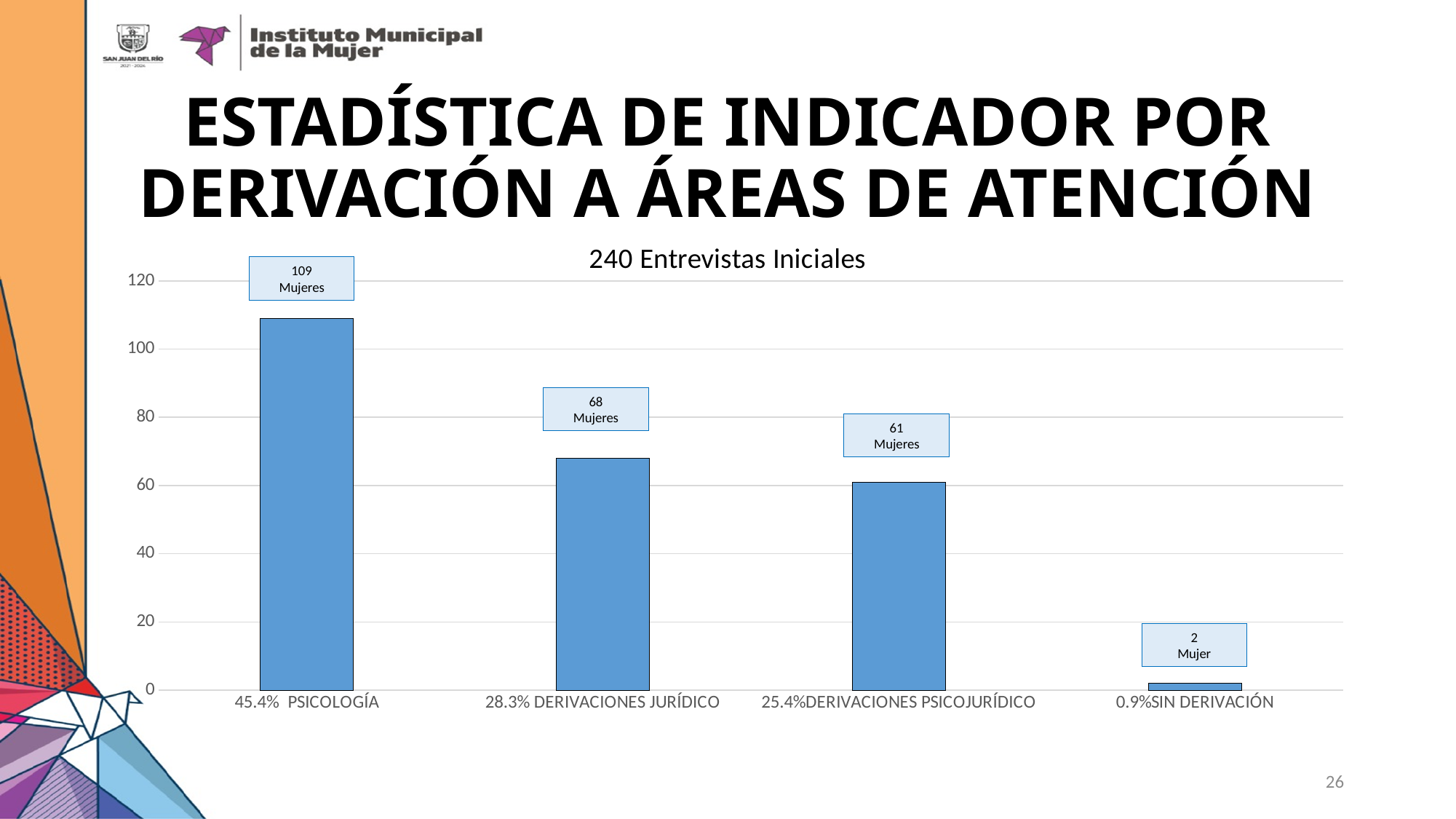
What is the value for SIN DERIVACIÓN? 2 Which category has the highest value? PSICOLOGÍA What is the value for DERIVACIONES PSICOJURÍDICO? 61 What is the difference between the values for PSICOLOGÍA and DERIVACIONES JURÍDICO? 41 Which category has the lowest value? SIN DERIVACIÓN Which is larger, DERIVACIONES JURÍDICO or DERIVACIONES PSICOJURÍDICO? DERIVACIONES JURÍDICO What is the value for DERIVACIONES JURÍDICO? 68 What kind of chart is shown on the slide? bar chart What is the value for PSICOLOGÍA? 109 How many categories are shown in the chart? 4 What is the title of the chart? 240 Entrevistas Iniciales Is the value for DERIVACIONES PSICOJURÍDICO greater or less than 80? less